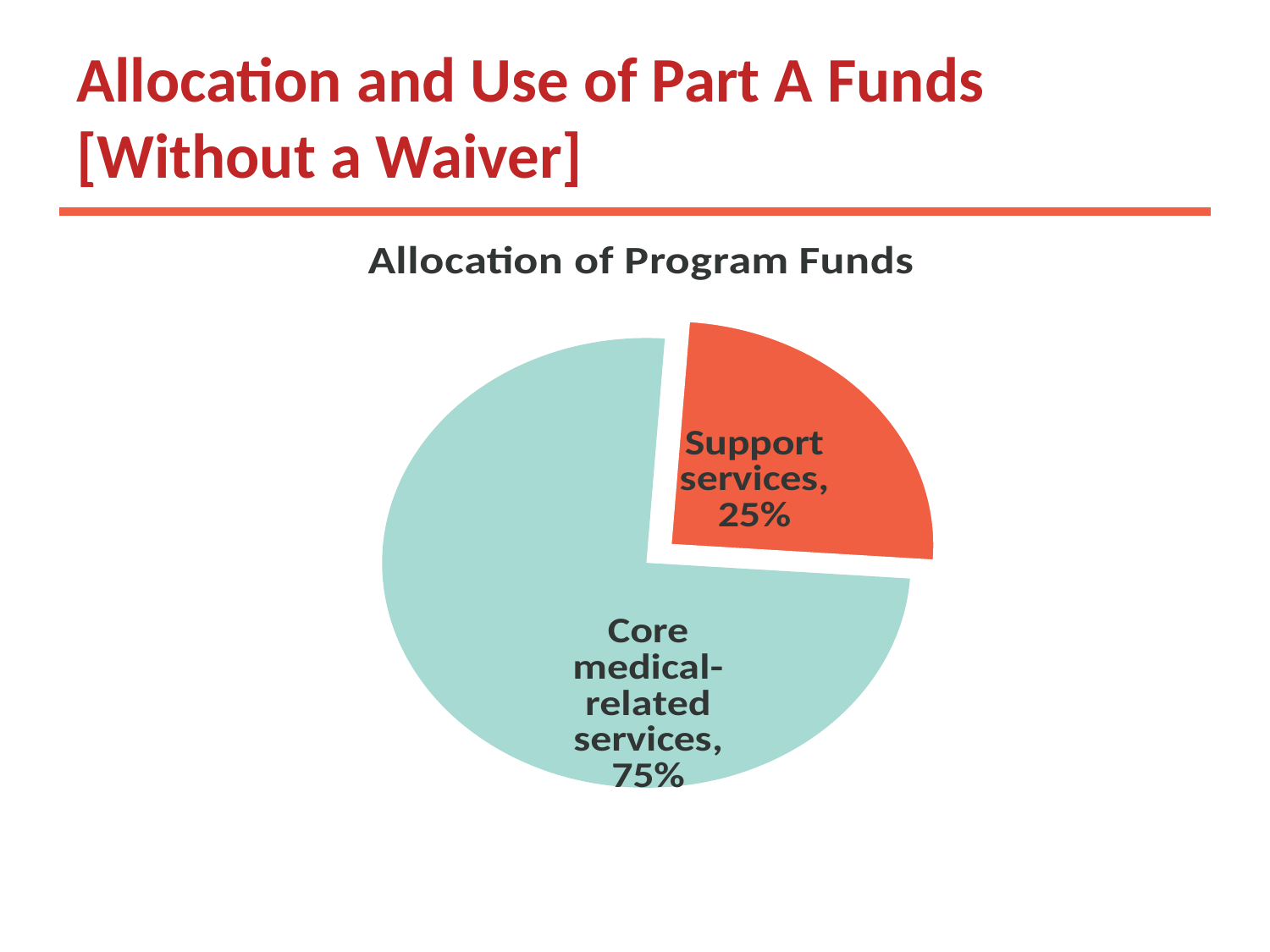
What kind of chart is shown on the slide? Pie chart What is the difference in percentage points between the Core medical-related services share and the Support services share? 50 percentage points What share of program funds goes to Support services? 25% Is the share for Support services greater or less than 50%? less What share of program funds goes to Core medical-related services? 75% What is the title of the chart? Allocation of Program Funds Which category receives the largest share of program funds? Core medical-related services Which is larger: the share for Support services or the share for Core medical-related services? Core medical-related services What colour is the Support services slice? Orange-red Which category receives the smallest share of program funds? Support services Is the share for Core medical-related services greater or less than 50%? greater How many slices does the pie chart have? 2